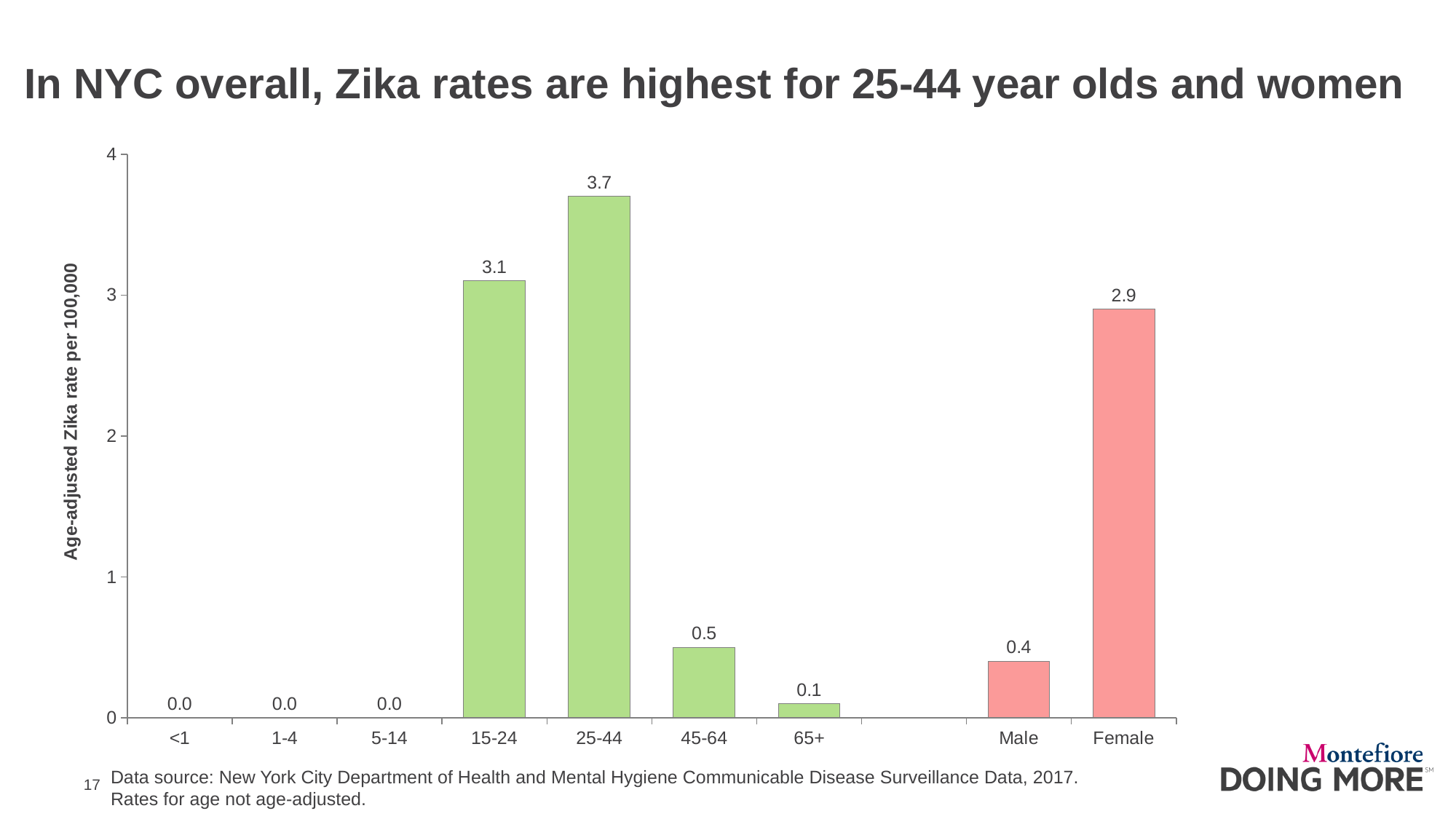
What is the Zika rate per 100,000 for the 25-44 age group? 3.7 What is the Zika rate per 100,000 for males? 0.4 How many age groups have a Zika rate of 0.0? 3 Which age group has the highest Zika rate? 25-44 What type of chart is shown on the slide? Bar chart What is the Zika rate per 100,000 for the 45-64 age group? 0.5 What is the Zika rate per 100,000 for females? 2.9 What is the difference between the Zika rates for females and males? 2.5 What is the difference between the Zika rates for the 25-44 and 15-24 age groups? 0.6 Which has a higher Zika rate, the 15-24 age group or females? 15-24 Which age group has the lowest non-zero Zika rate? 65+ What is the label of the vertical axis? Age-adjusted Zika rate per 100,000